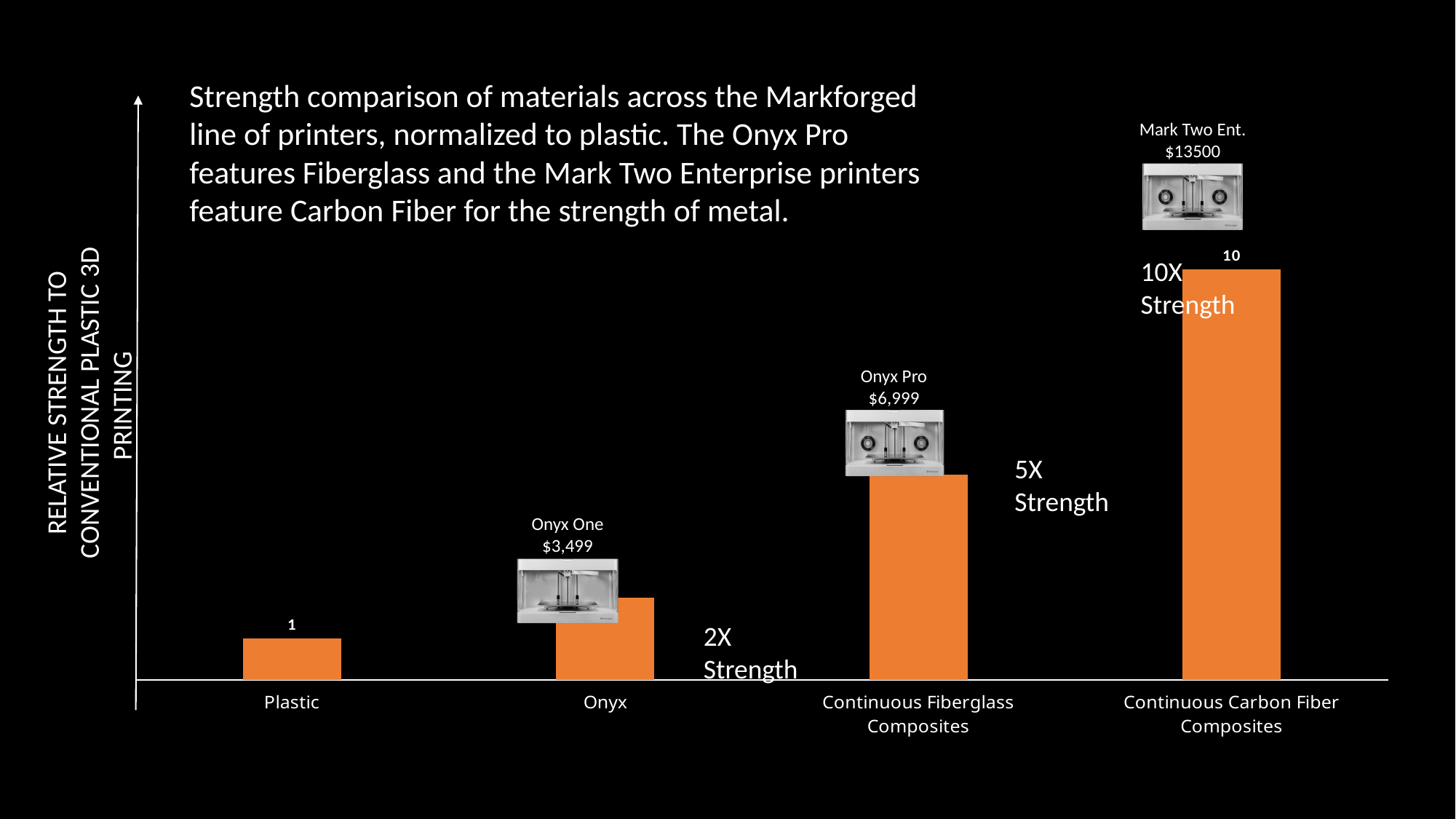
What is the value for Plastic? 1 How many categories are shown on the x axis? 4 Which category has the highest bar? Continuous Carbon Fiber Composites Do the bar values rise or fall from left to right along the x axis? Rise What is the value for Continuous Carbon Fiber Composites? 10 Which category has the lowest bar? Plastic What price is shown for the Onyx Pro printer? $6,999 Which is larger, the value for Onyx or the value for Continuous Fiberglass Composites? Continuous Fiberglass Composites What kind of chart is shown on the slide? Bar chart What price is shown for the Mark Two Ent. printer? $13500 What is the difference between the values for Continuous Carbon Fiber Composites and Plastic? 9